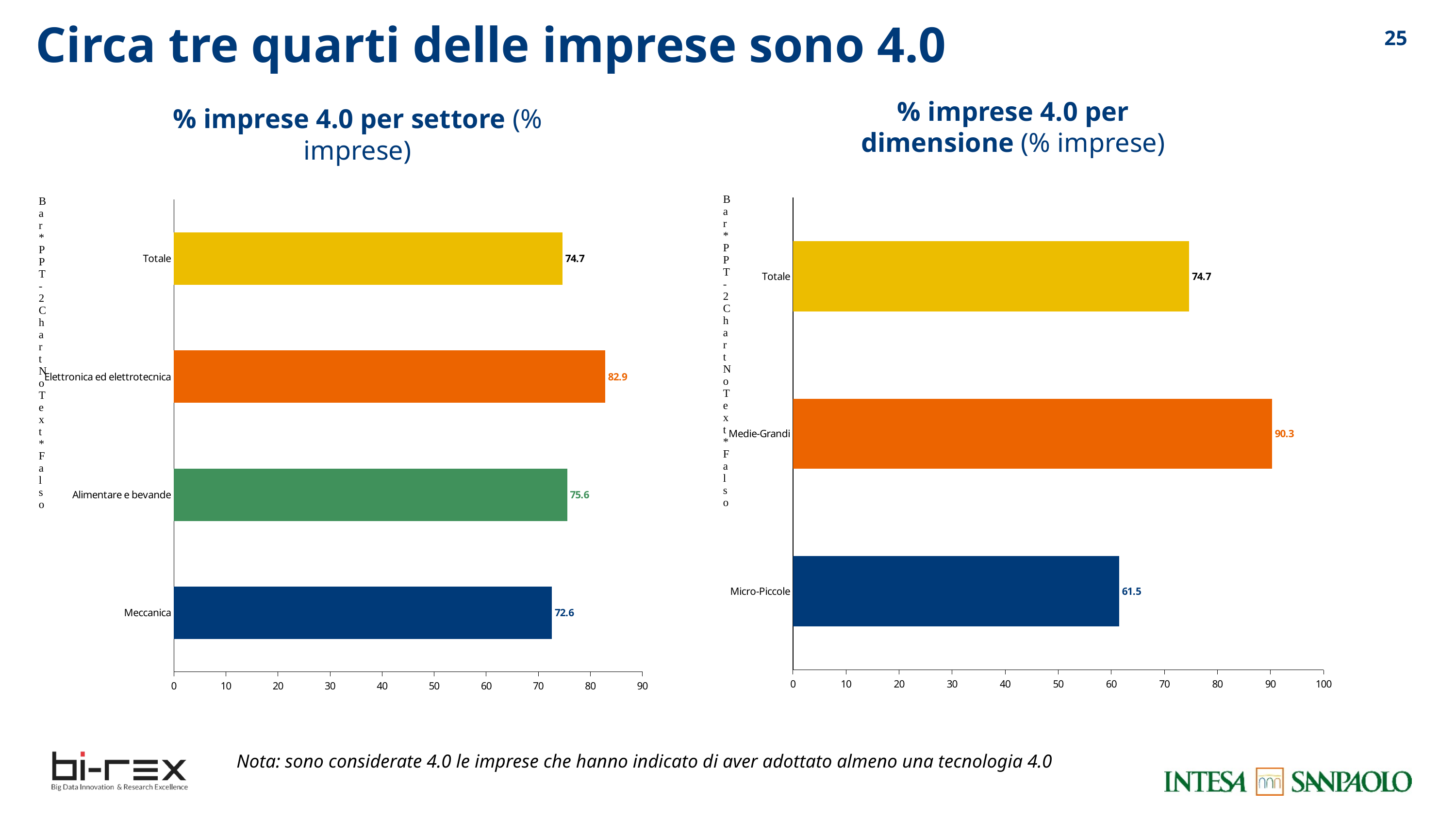
What type of chart is the '% imprese 4.0 per dimensione' chart? Bar chart In the '% imprese 4.0 per dimensione' chart, what is the value for Micro-Piccole? 61.5 In the '% imprese 4.0 per settore' chart, what is the value for Meccanica? 72.6 In the '% imprese 4.0 per dimensione' chart, how many categories are shown? 3 In the '% imprese 4.0 per settore' chart, what is the difference between Elettronica ed elettrotecnica and Alimentare e bevande? 7.3 In the '% imprese 4.0 per dimensione' chart, what is the difference between Medie-Grandi and Micro-Piccole? 28.8 In the '% imprese 4.0 per dimensione' chart, what is the value for Medie-Grandi? 90.3 In the '% imprese 4.0 per dimensione' chart, which is larger, Totale or Micro-Piccole? Totale In the '% imprese 4.0 per settore' chart, which category has the lowest value? Meccanica In the '% imprese 4.0 per settore' chart, how many bars are shown? 4 In the '% imprese 4.0 per settore' chart, which category has the highest value? Elettronica ed elettrotecnica In the '% imprese 4.0 per settore' chart, what is the value for Elettronica ed elettrotecnica? 82.9